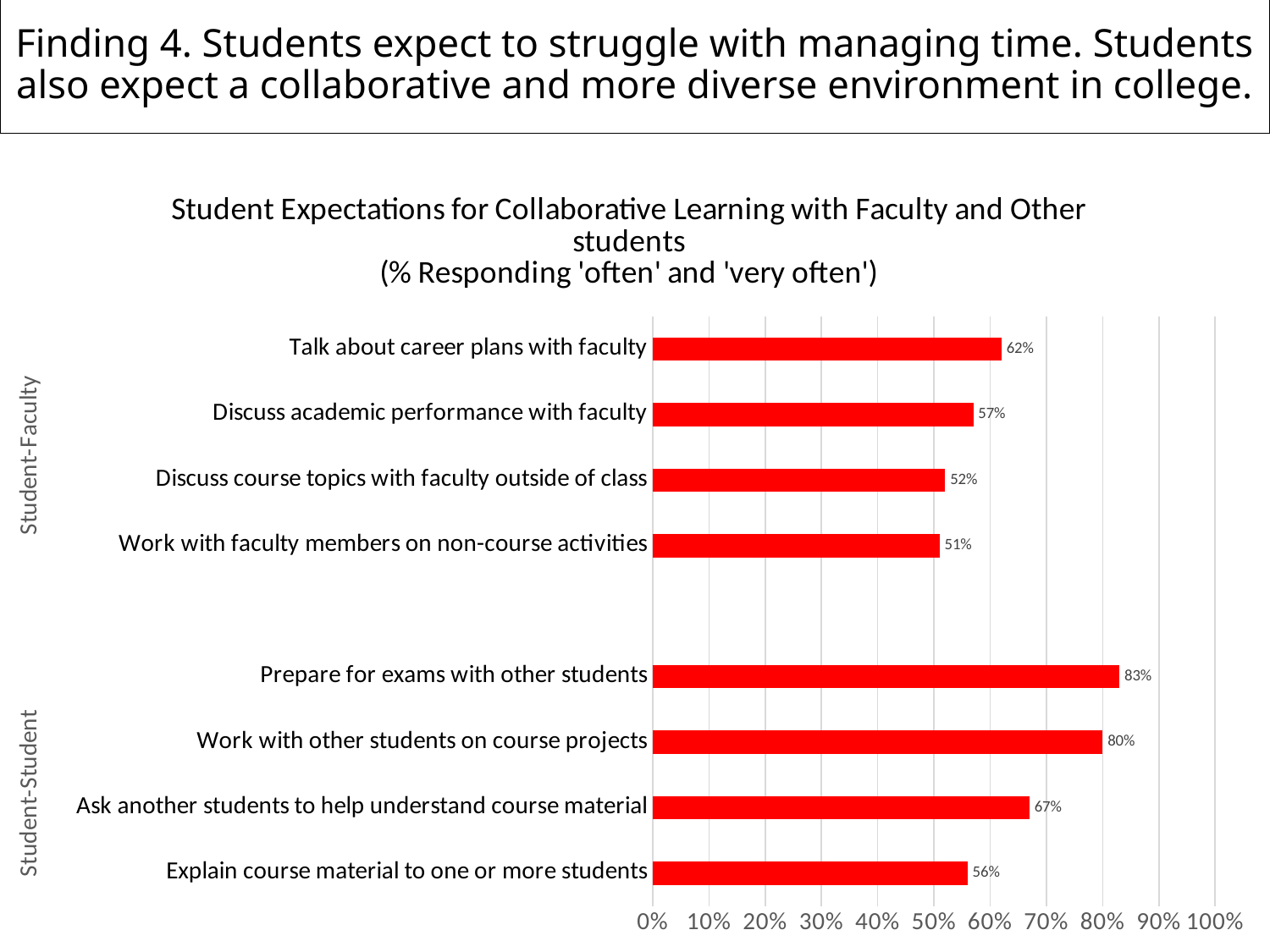
What colour are the bars in the chart? red What percentage of students expect to talk about career plans with faculty often or very often? 62% How many categories are plotted in the chart? 8 What kind of chart is shown on the slide? bar chart Which category has the highest value in the chart? Prepare for exams with other students What are the two group labels shown along the left side of the chart? Student-Faculty and Student-Student What is the difference between 'Prepare for exams with other students' and 'Explain course material to one or more students'? 27% What is the value for 'Work with faculty members on non-course activities'? 51% Which is larger: 'Discuss academic performance with faculty' or 'Ask another students to help understand course material'? Ask another students to help understand course material Which category has the lowest value in the chart? Work with faculty members on non-course activities Is the value for 'Discuss course topics with faculty outside of class' greater or less than 60%? less What is the value for 'Work with other students on course projects'? 80%